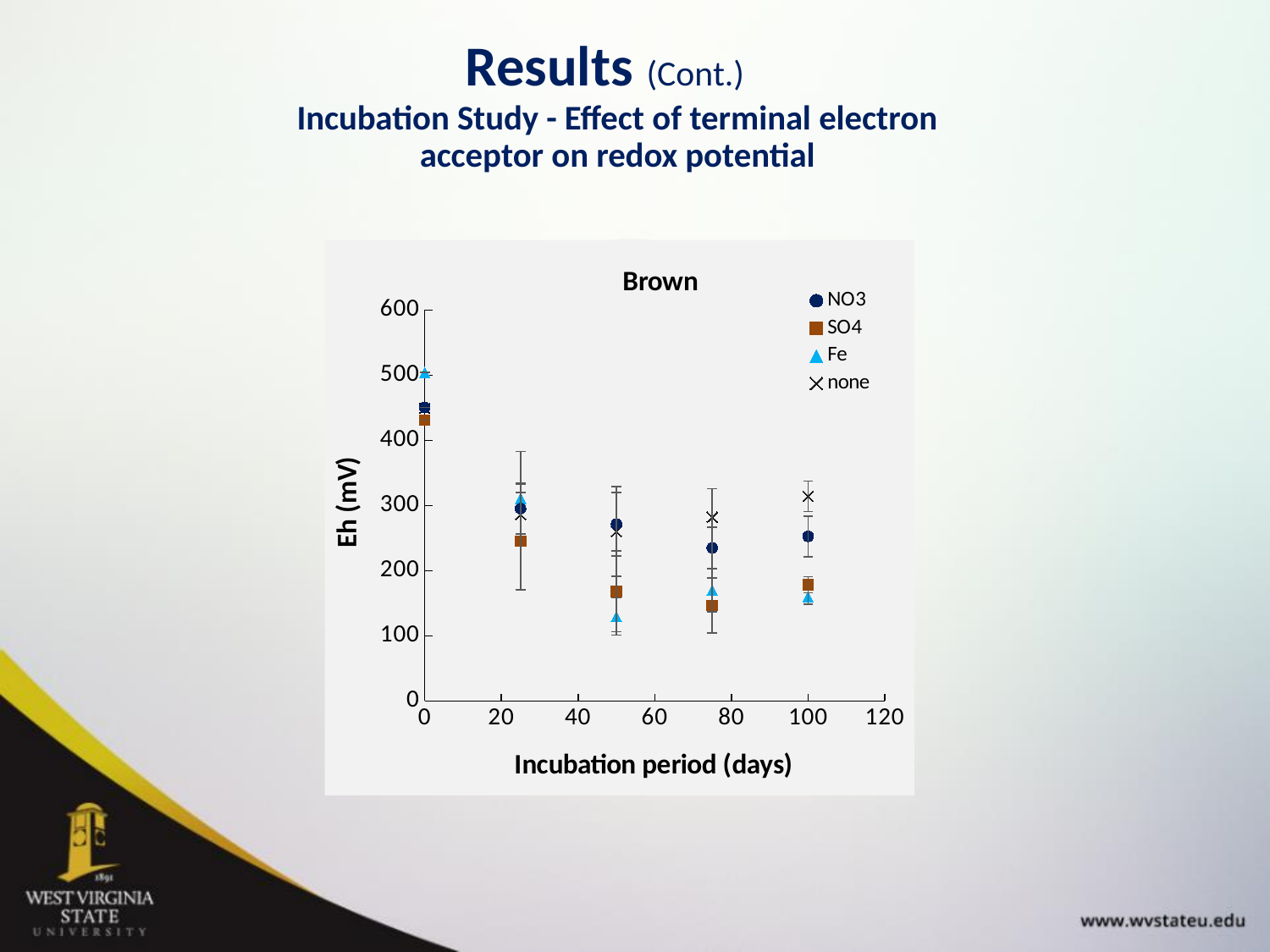
Is the Eh value for none at 100 days greater or less than 200? greater At 50 days, which has the larger Eh value, NO3 or Fe? NO3 At 100 days, which series has the highest Eh value? none What are the four series named in the legend of the Brown chart? NO3, SO4, Fe, none What kind of chart is shown on the slide? Scatter chart Is the Eh value for Fe at 0 days greater or less than 400? greater Does the Eh value for NO3 rise or fall from 0 days to 100 days? fall Is the Eh value for SO4 at 50 days greater or less than 200? less How many series does the legend of the Brown chart list? 4 At 50 days, which series has the lowest Eh value? Fe What is the title of the x axis of the Brown chart? Incubation period (days) At 100 days, which has the larger Eh value, none or SO4? none